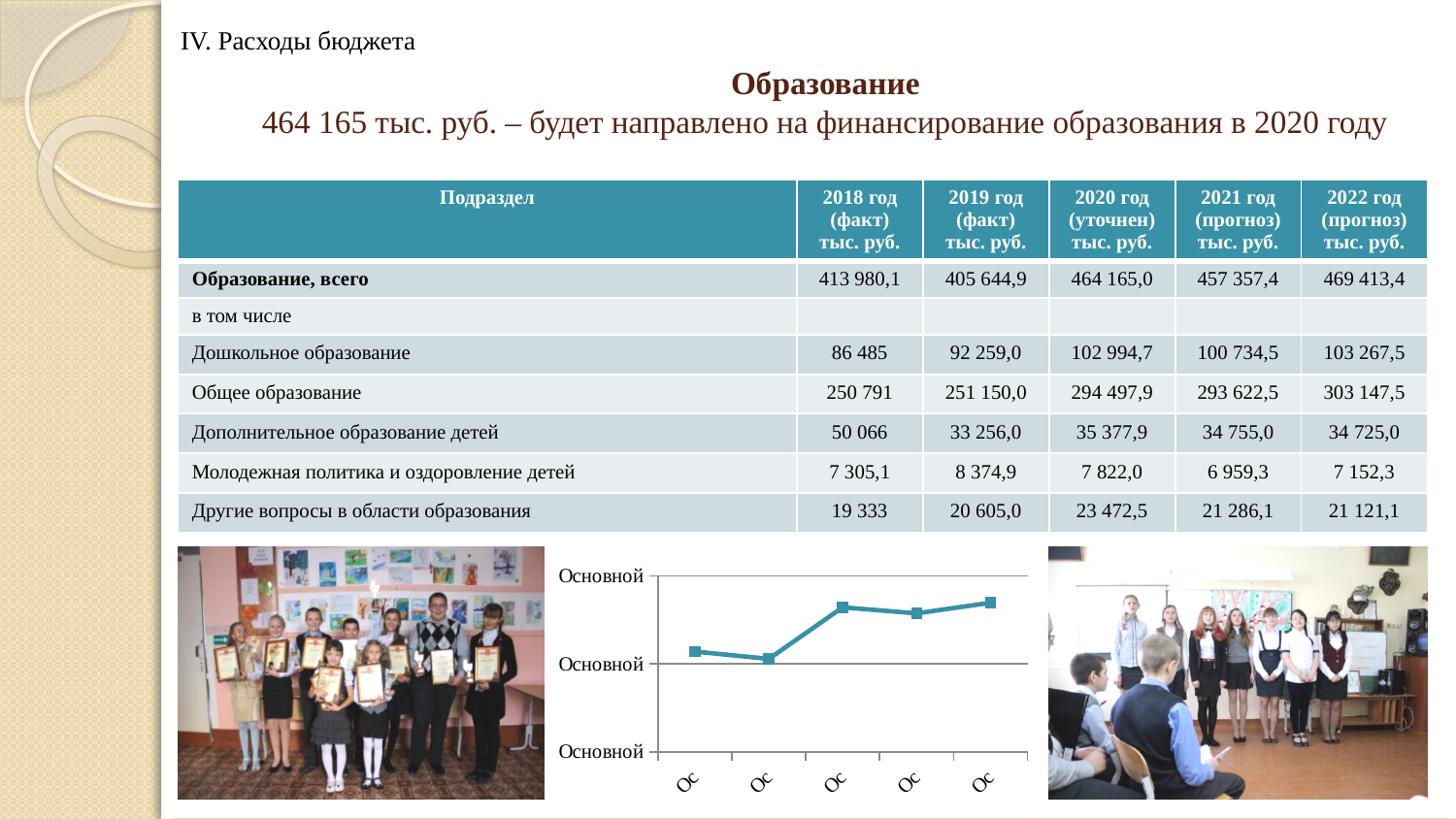
How many tick labels are shown on the vertical axis of the line chart at the bottom of the slide? 3 What text is shown as each tick label on the vertical axis of the line chart at the bottom of the slide? Основной On the line chart at the bottom of the slide, does the line go up or down between the second and third points? up On the line chart at the bottom of the slide, is the last point higher or lower than the first point? higher How many data points are plotted on the line chart at the bottom of the slide? 5 What kind of chart is shown at the bottom centre of the slide? line chart